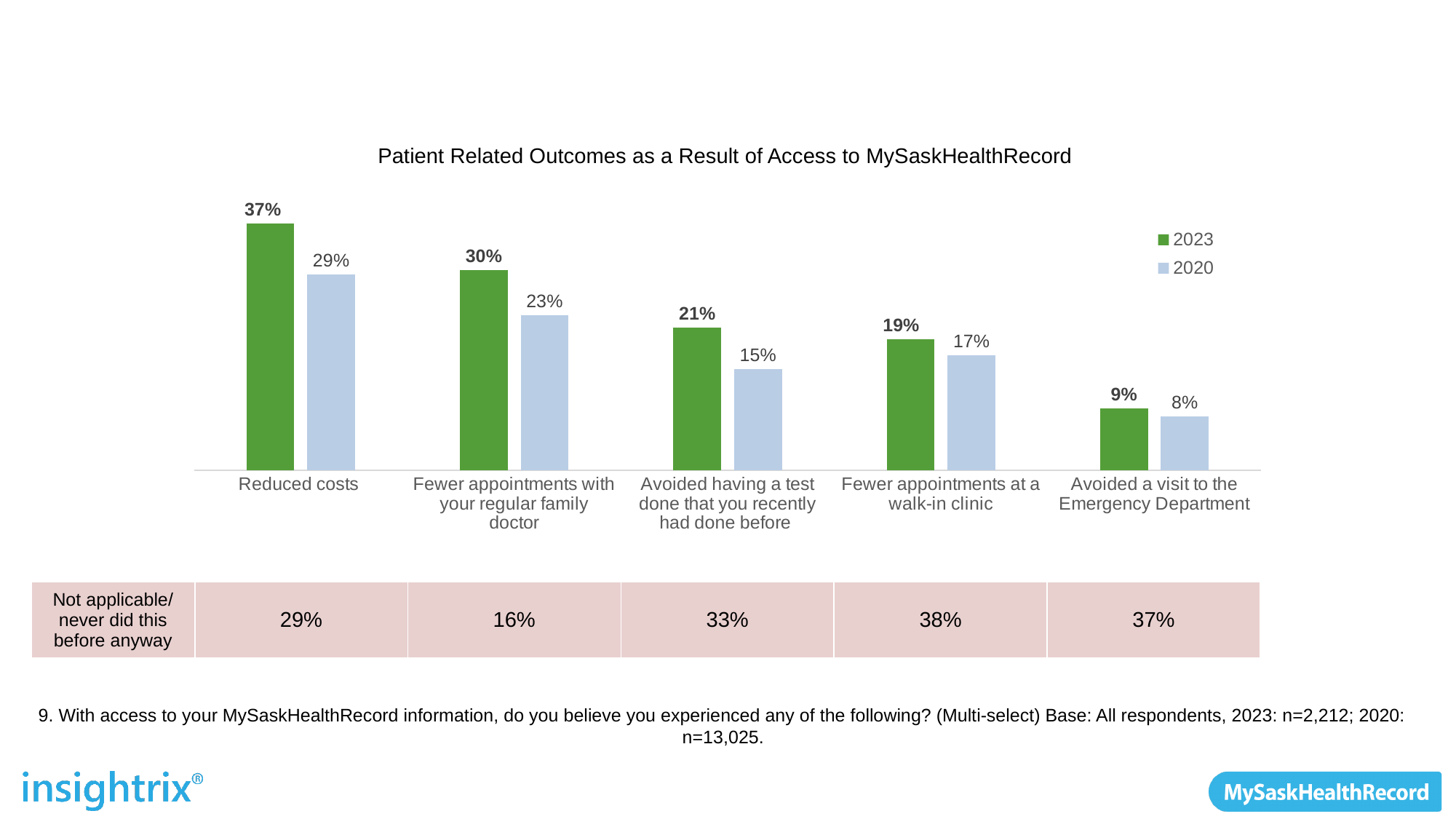
What is the 2020 value for Avoided having a test done that you recently had done before? 15% How many series does the legend list? 2 Which category has the lowest 2020 value? Avoided a visit to the Emergency Department What is the 2023 value for Reduced costs? 37% What is the 2023 value for Fewer appointments at a walk-in clinic? 19% What is the difference between the 2023 and 2020 values for Fewer appointments with your regular family doctor? 7% Which category has the highest 2023 value? Reduced costs What kind of chart is shown on the slide? Bar chart What is the title of the chart? Patient Related Outcomes as a Result of Access to MySaskHealthRecord Do the 2023 values rise or fall moving from left to right across the categories? Fall How many categories are shown on the x axis of the chart? 5 Which is larger for Avoided a visit to the Emergency Department: the 2023 value or the 2020 value? 2023